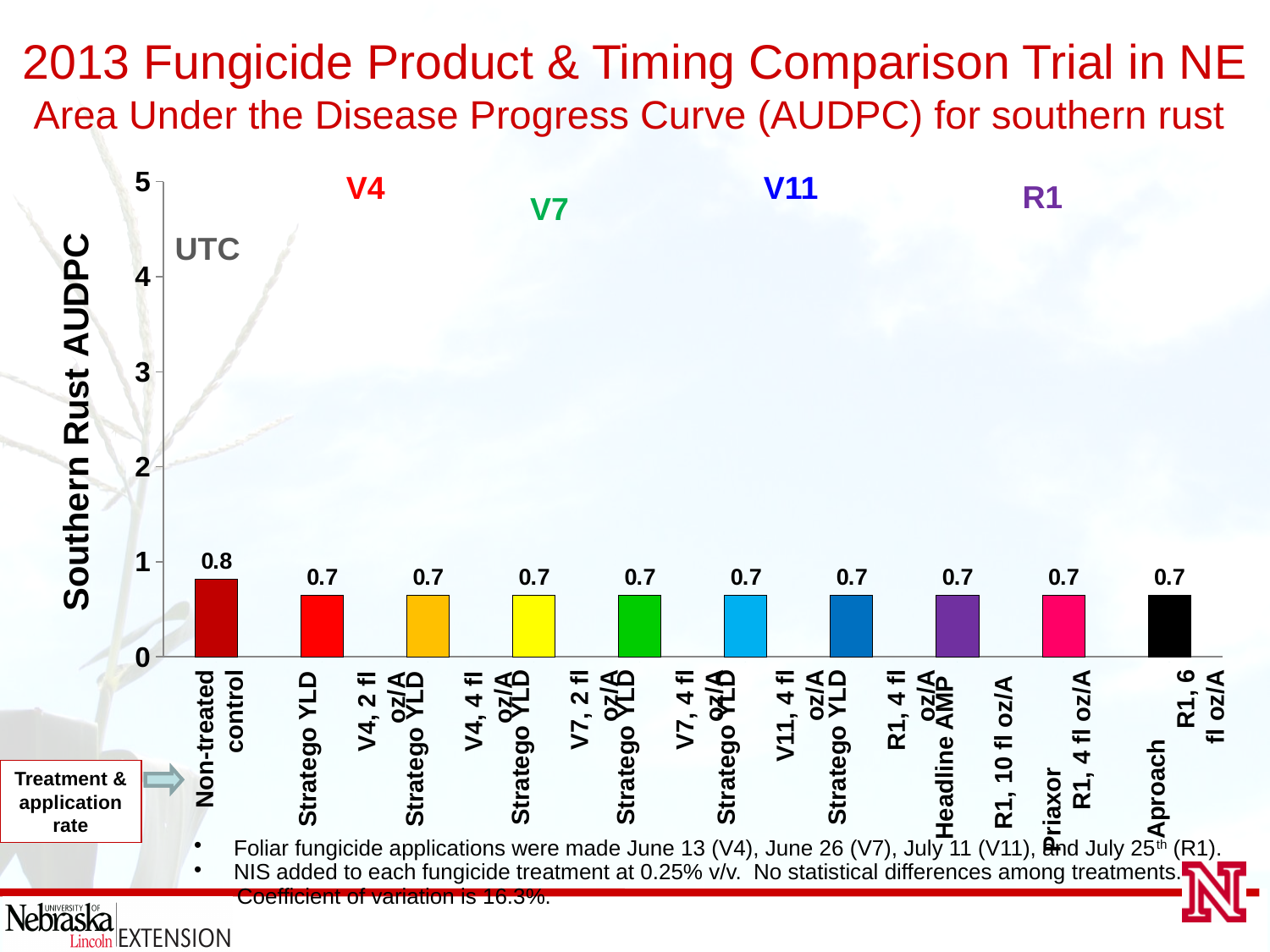
What is the Southern Rust AUDPC value for Aproach at R1, 6 fl oz/A? 0.7 How many treatments (bars) are shown in the chart? 10 What is the Southern Rust AUDPC value for the Non-treated control? 0.8 What kind of chart is shown on the slide? Bar chart What is the difference between the Southern Rust AUDPC value for the Non-treated control and for Priaxor at R1, 4 fl oz/A? 0.1 What is the Southern Rust AUDPC value for Headline AMP at R1, 10 fl oz/A? 0.7 Which has a larger Southern Rust AUDPC value, the Non-treated control or Stratego YLD at V4, 2 fl oz/A? Non-treated control What is the label of the vertical axis of the chart? Southern Rust AUDPC Is the Southern Rust AUDPC value for the Non-treated control greater or less than 1? less What is the maximum value shown on the vertical axis of the chart? 5 Which treatment has the highest Southern Rust AUDPC value? Non-treated control